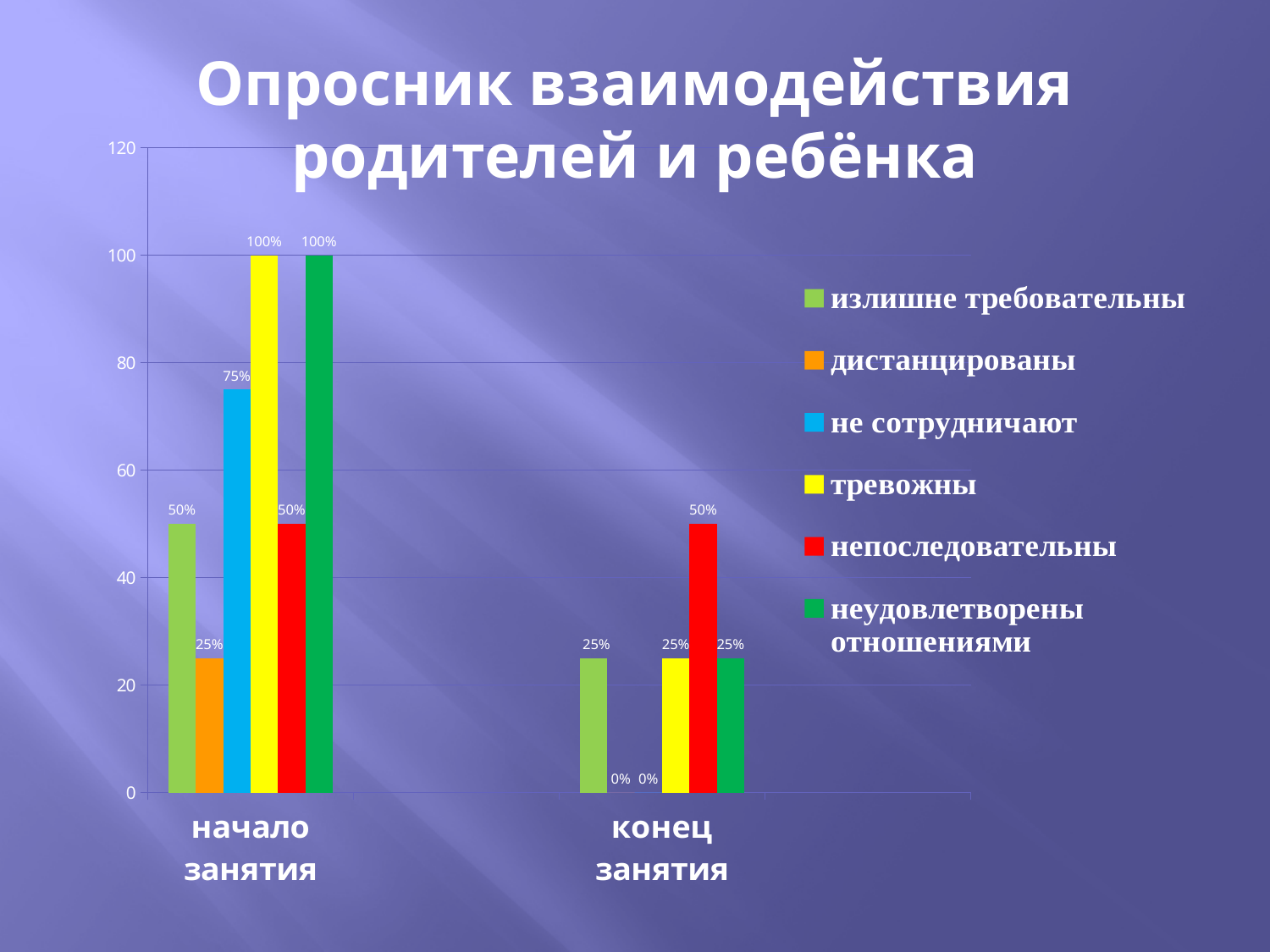
What is the value for "непоследовательны" at "конец занятия"? 50% Which is larger: "излишне требовательны" at "начало занятия" or at "конец занятия"? начало занятия How many series does the legend list? 6 Which series has the lowest value at "начало занятия"? дистанцированы What is the difference between the "тревожны" values at "начало занятия" and "конец занятия"? 75% What is the value for "не сотрудничают" at "конец занятия"? 0% What is the value for "дистанцированы" at "начало занятия"? 25% What kind of chart is shown on the slide? bar chart What is the value for "не сотрудничают" at "начало занятия"? 75% Which series has the highest value at "конец занятия"? непоследовательны How many categories are shown on the x axis? 2 What colour represents "неудовлетворены отношениями" in the legend? green